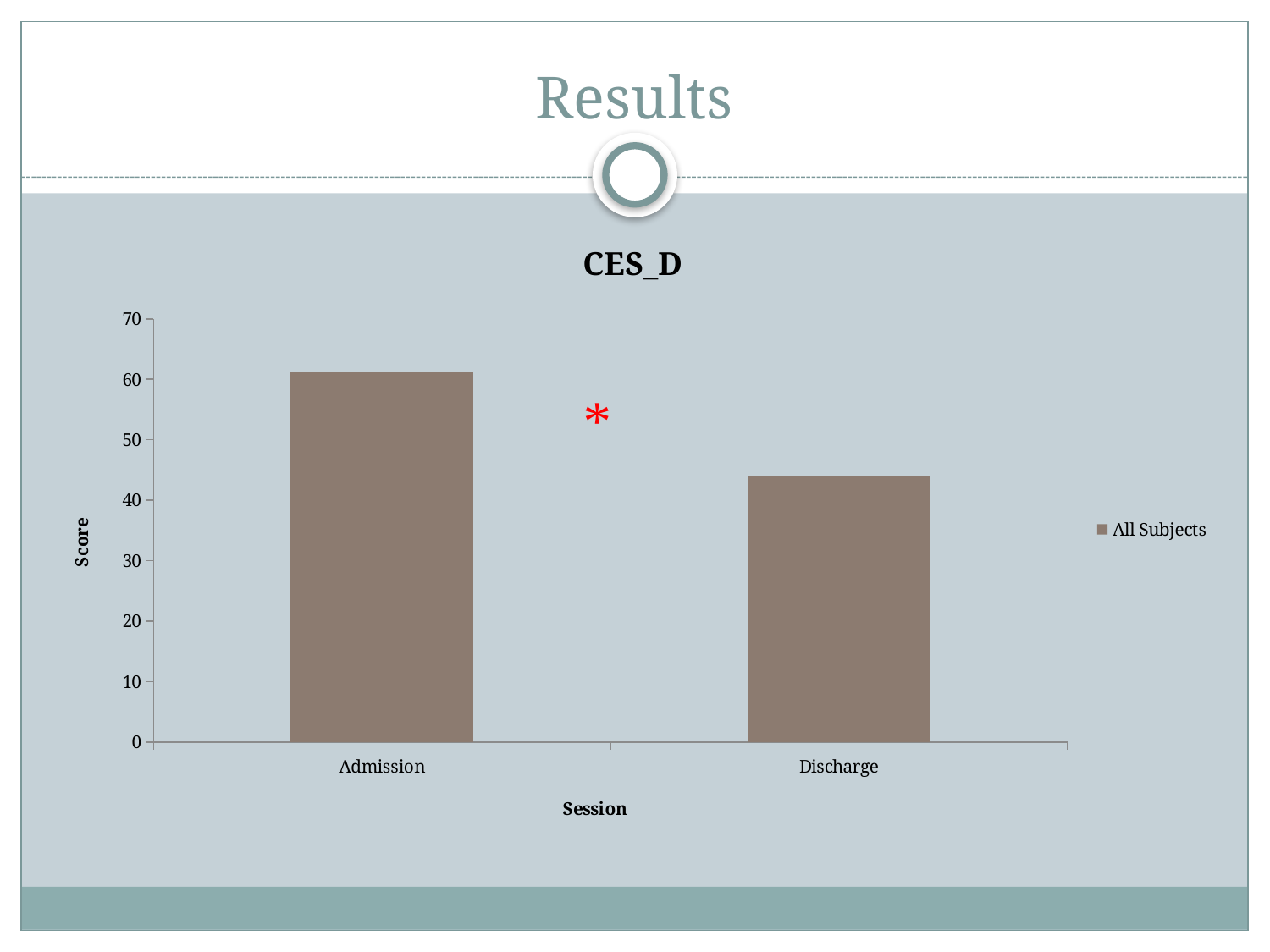
Which session has the highest score? Admission Is the score for Discharge greater or less than 50? less How many categories are shown on the x axis of the chart? 2 Which session has the lowest score? Discharge Is the score for Admission greater or less than 50? greater Do the scores rise or fall from Admission to Discharge? fall How many series does the legend list? 1 Is the score for Discharge greater or less than 40? greater What is the label of the y axis? Score What is the title of the chart? CES_D Which is larger, the score at Admission or the score at Discharge? Admission What type of chart is shown on the slide? bar chart